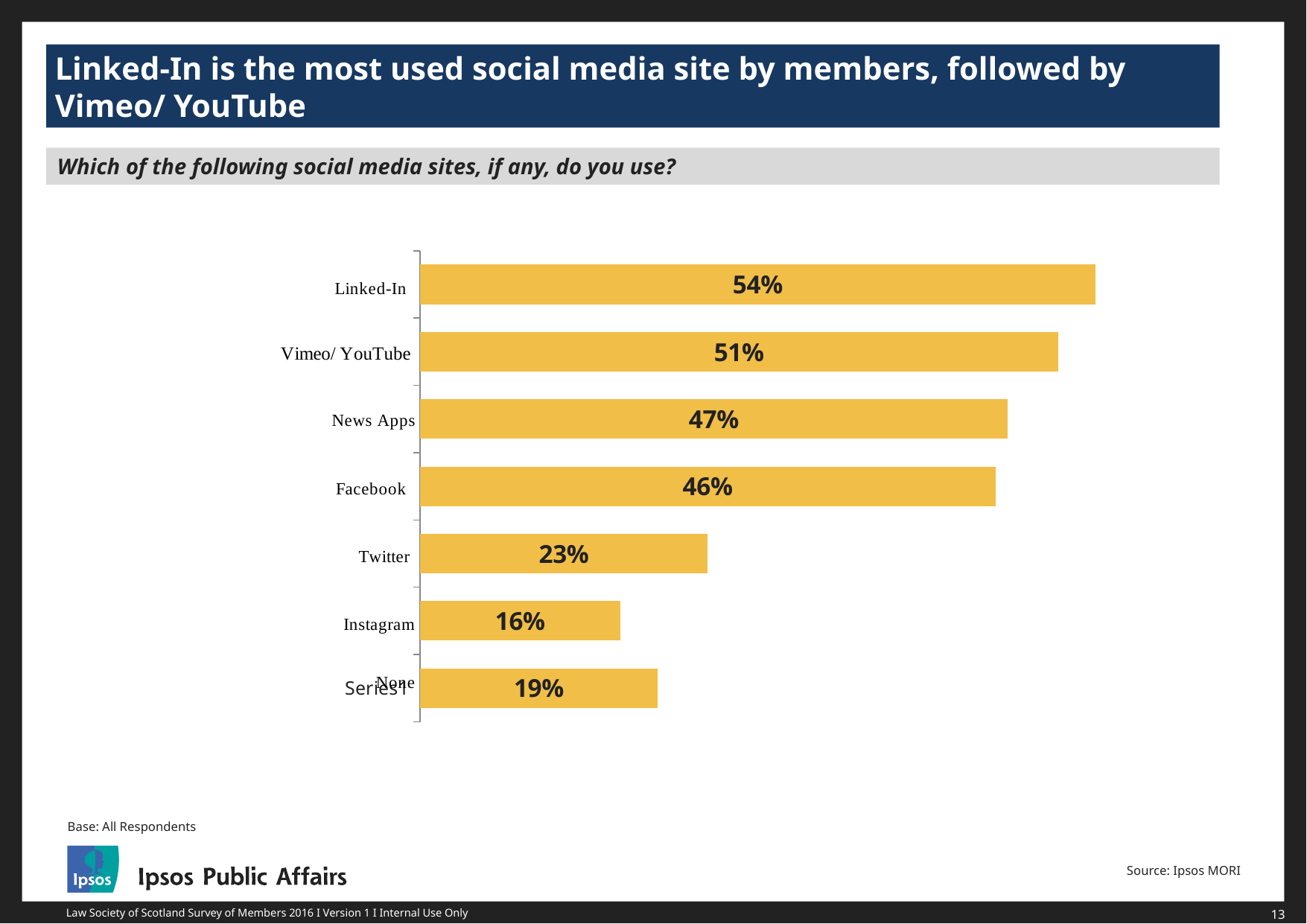
What percentage of members use Twitter? 23% Which social media site has the highest percentage of users? Linked-In What percentage of members use Linked-In? 54% What kind of chart is shown on the slide? Bar chart What percentage of members use News Apps? 47% How many categories are shown in the chart? 7 Which category has the lowest percentage? Instagram What percentage of members use Vimeo/ YouTube? 51% Which is larger, the value for Twitter or the value for Instagram? Twitter What percentage of members use Instagram? 16% What is the difference in percentage points between Linked-In and Facebook? 8 What is the survey question shown above the chart? Which of the following social media sites, if any, do you use?